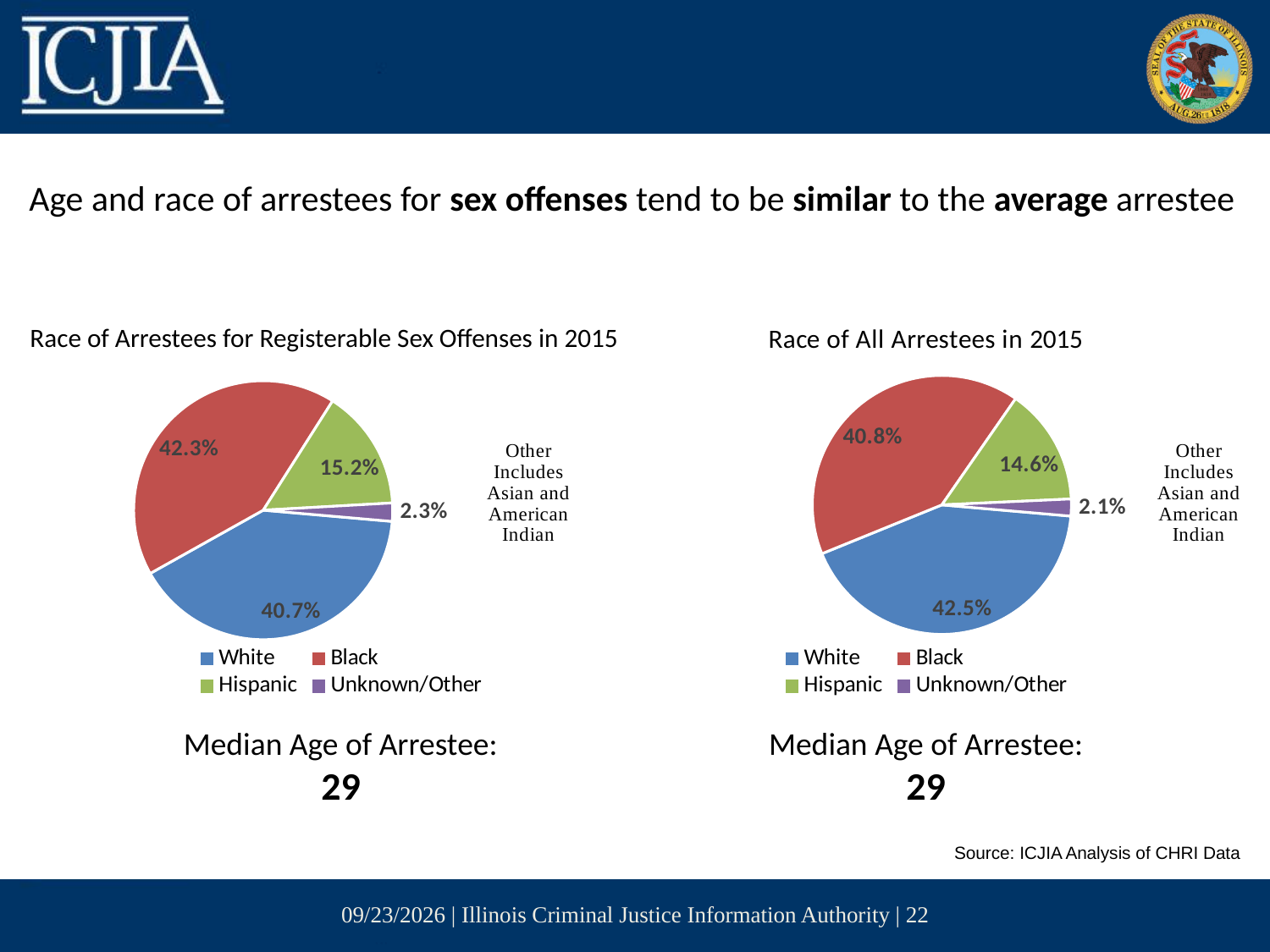
In the 'Race of Arrestees for Registerable Sex Offenses in 2015' chart, what percentage of arrestees are Hispanic? 15.2% In the 'Race of Arrestees for Registerable Sex Offenses in 2015' chart, what is the difference between the Black and White shares? 1.6% How many categories does the 'Race of All Arrestees in 2015' chart show? 4 In the 'Race of All Arrestees in 2015' chart, what colour represents the Hispanic category? Green In the 'Race of Arrestees for Registerable Sex Offenses in 2015' chart, which category has the smallest share? Unknown/Other In the 'Race of All Arrestees in 2015' chart, which category has the largest share? White In the 'Race of All Arrestees in 2015' chart, what percentage of arrestees are White? 42.5% What kind of chart is the 'Race of Arrestees for Registerable Sex Offenses in 2015' chart? Pie chart In the 'Race of All Arrestees in 2015' chart, what percentage of arrestees are Unknown/Other? 2.1% In the 'Race of All Arrestees in 2015' chart, what is the difference between the Hispanic and Unknown/Other shares? 12.5% In the 'Race of Arrestees for Registerable Sex Offenses in 2015' chart, what percentage of arrestees are Black? 42.3% Which is larger: the Hispanic share in the 'Race of Arrestees for Registerable Sex Offenses in 2015' chart or the Hispanic share in the 'Race of All Arrestees in 2015' chart? Race of Arrestees for Registerable Sex Offenses in 2015